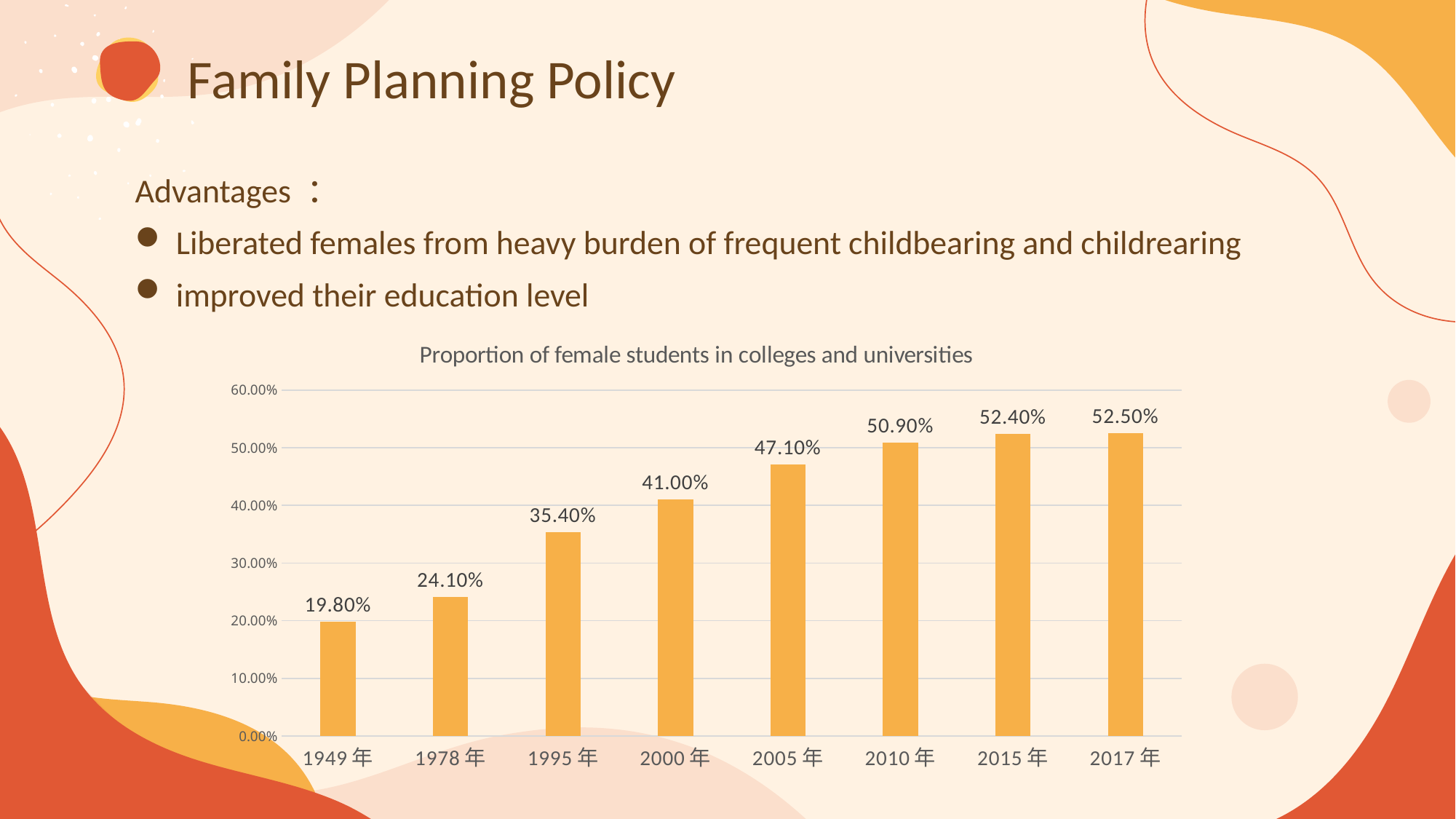
Which is larger, the value for 2000年 or the value for 1995年? 2000年 Which year has the lowest proportion of female students? 1949年 Which year has the highest proportion of female students? 2017年 What is the difference between the values for 1978年 and 1949年? 4.30% What is the value for 2010年? 50.90% What kind of chart is shown on the slide? bar chart Do the values rise or fall from 1949年 to 2017年? rise What value is shown for 2000年? 41.00% What is the proportion of female students in colleges and universities in 1949年? 19.80% What is the difference between the values for 2005年 and 1995年? 11.70% Is the value for 2015年 greater or less than 50.00%? greater How many years are shown on the x axis? 8